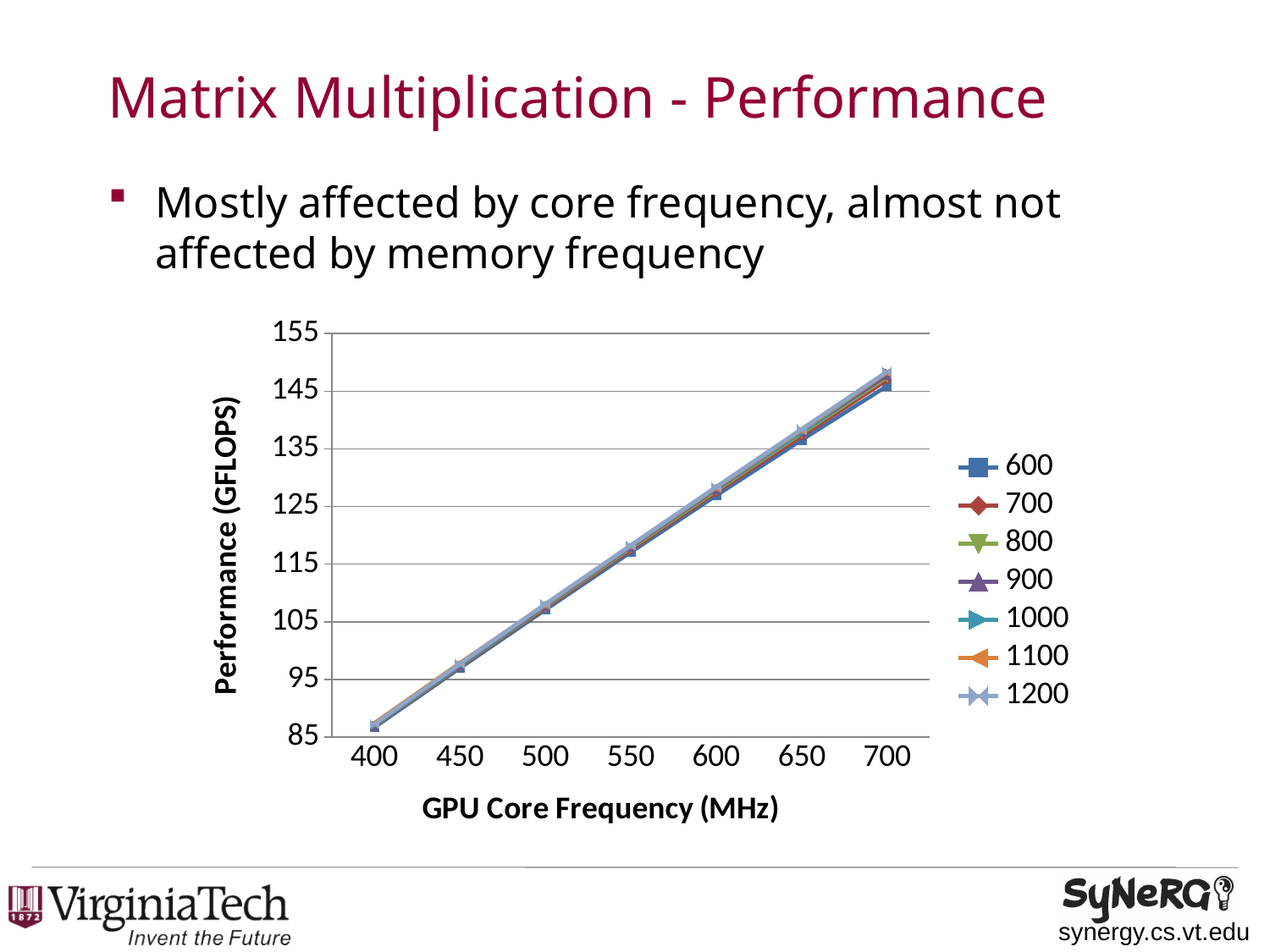
How many series does the legend list? 7 What is the label of the y axis? Performance (GFLOPS) How many GPU core frequency points are plotted along the x axis? 7 At which GPU core frequency is performance highest? 700 Is the performance value for the 600 series at 600 MHz greater or less than 115? greater Do the performance values rise or fall as GPU core frequency increases from 400 to 700 MHz? rise Is the performance value for the 1200 series at 650 MHz greater or less than 125? greater What kind of chart is shown on the slide? line chart Is the performance value for the 1200 series at 700 MHz greater or less than 145? greater What is the label of the x axis? GPU Core Frequency (MHz)